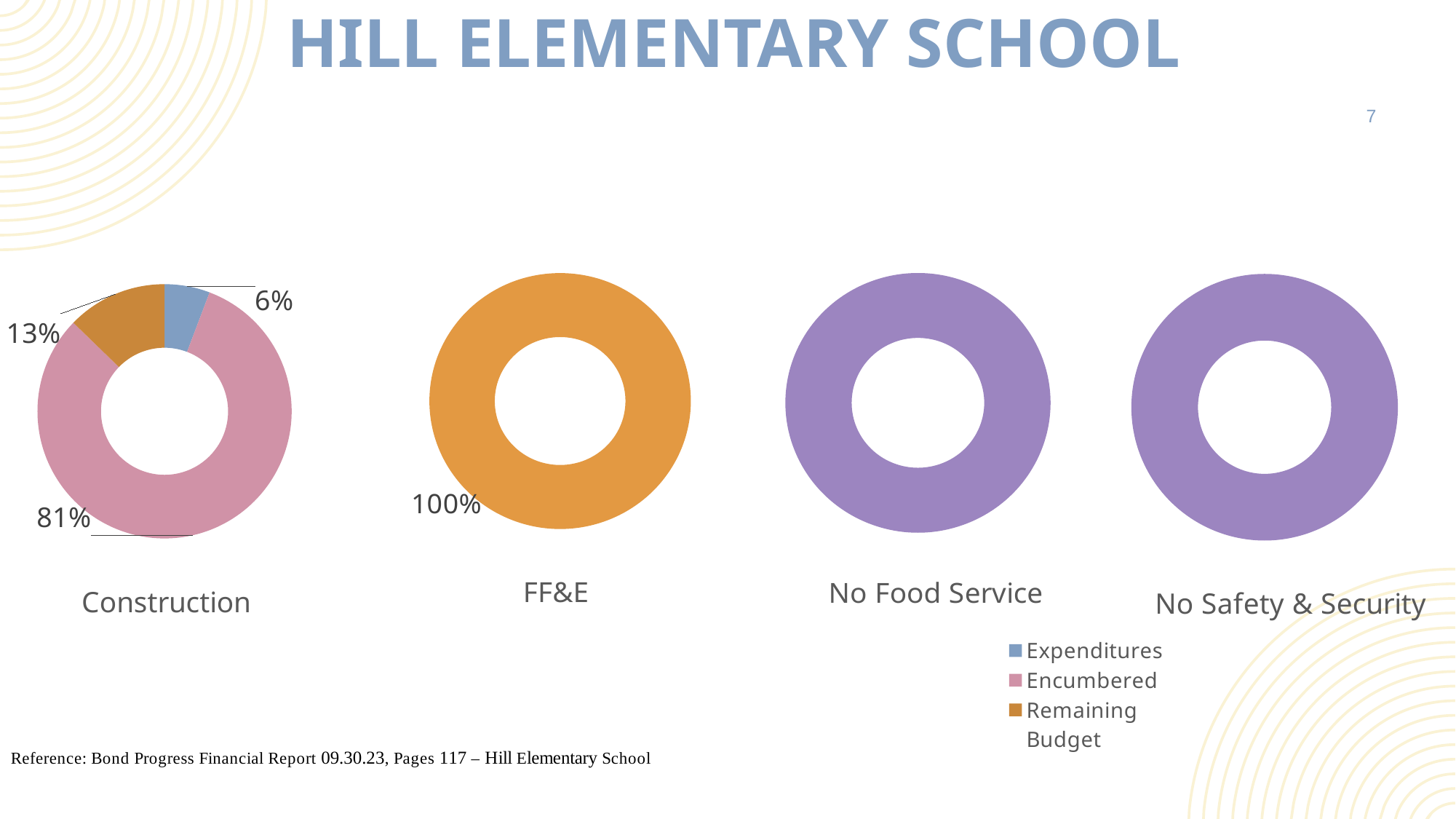
In the FF&E chart, what percentage is shown for Remaining Budget? 100% In the Construction chart, what percentage is Encumbered? 81% In the Construction chart, what percentage is Expenditures? 6% In the Construction chart, what percentage is Remaining Budget? 13% In the Construction chart, which category has the smallest share? Expenditures What kind of chart is used for Construction? Donut (pie) chart In the Construction chart, which is larger, Remaining Budget or Expenditures? Remaining Budget How many entries does the legend list? 3 How many donut charts are shown on the slide? 4 In the Construction chart, which category has the largest share? Encumbered In the Construction chart, what is the difference between the Encumbered share and the Remaining Budget share? 68% Which legend entry is shown in orange? Remaining Budget